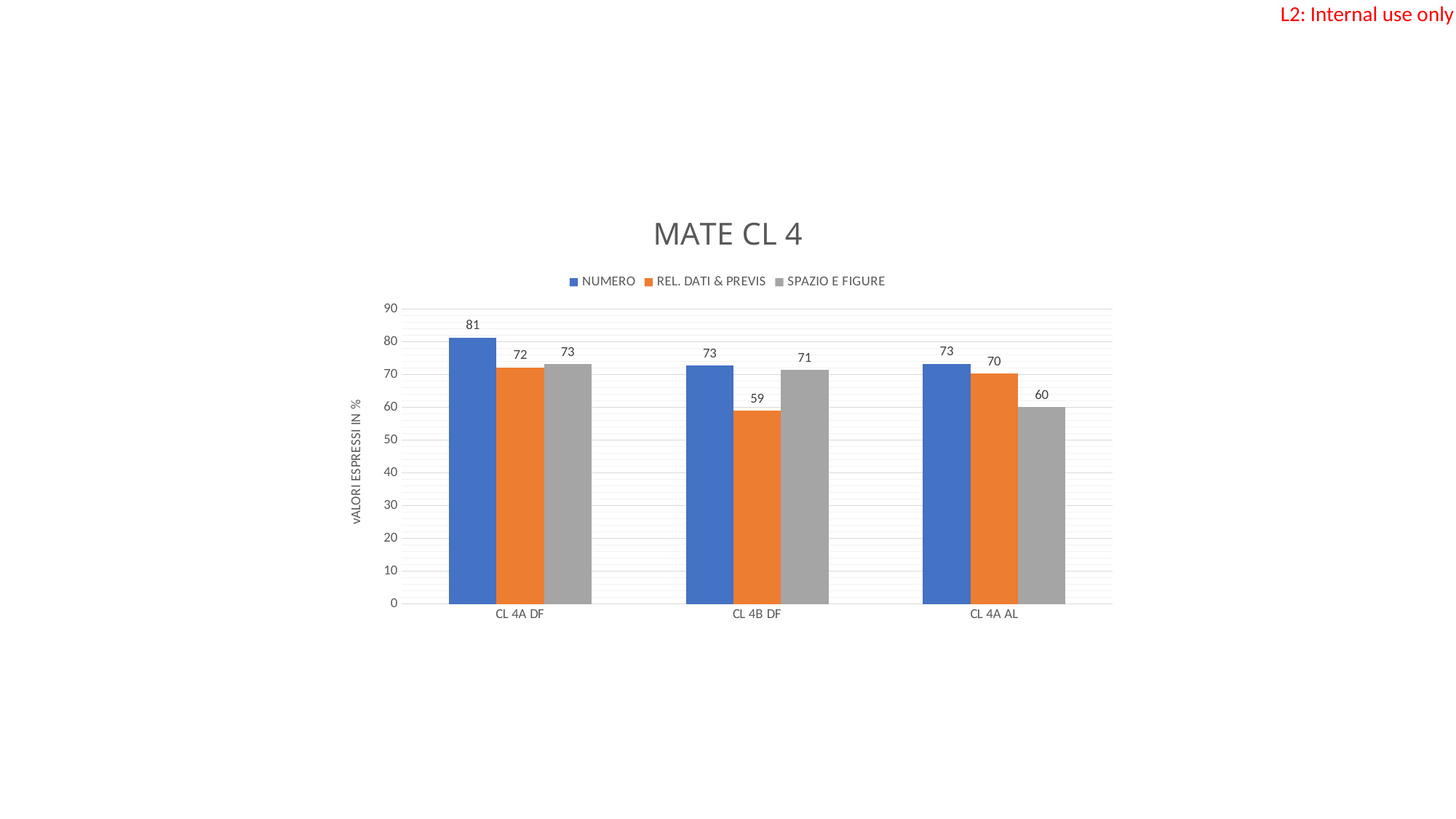
How many series does the legend list? 3 What is the value for REL. DATI & PREVIS in CL 4B DF? 59 What is the difference between the NUMERO value and the REL. DATI & PREVIS value in CL 4B DF? 14 What is the label of the vertical axis? VALORI ESPRESSI IN % What is the title of the chart? MATE CL 4 Which is larger in CL 4A AL: the REL. DATI & PREVIS value or the SPAZIO E FIGURE value? REL. DATI & PREVIS Which category has the lowest REL. DATI & PREVIS value? CL 4B DF What kind of chart is shown? Bar chart What is the value for NUMERO in CL 4A DF? 81 What is the value for SPAZIO E FIGURE in CL 4A AL? 60 How many categories are shown on the x axis? 3 Which category has the highest NUMERO value? CL 4A DF